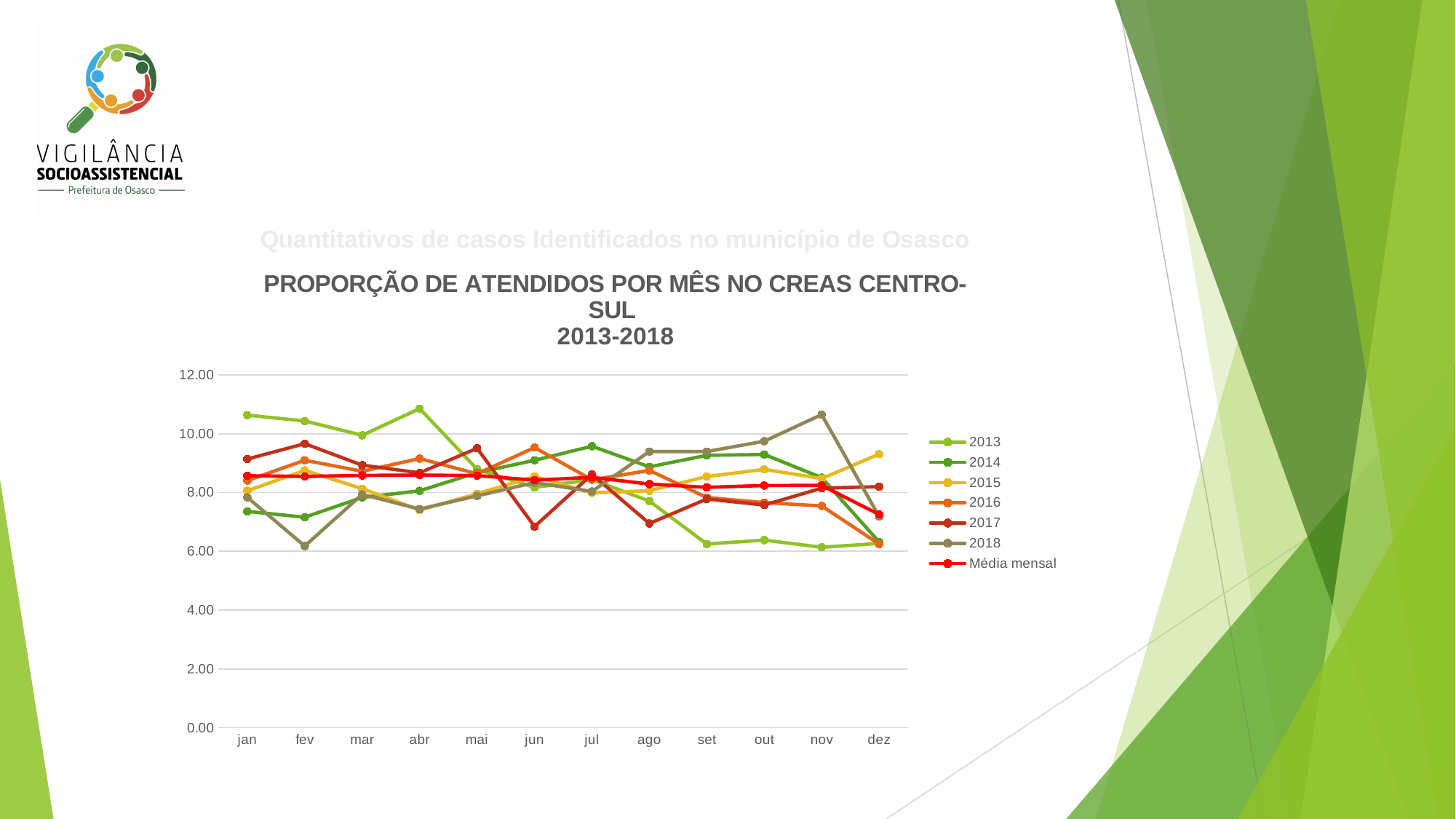
What kind of chart is shown on the slide? line chart Does the 2013 series rise or fall overall from jan to dez? fall Which series has the highest value in jan? 2013 How many months are shown along the x axis? 12 Is the value for 2013 in abr greater or less than 10.00? greater Which series has the lowest value in fev? 2018 How many series does the legend list? 7 Which series has the highest value in nov? 2018 Is the value for 2017 in jun greater or less than 8.00? less Is the value for 2018 in fev greater or less than 8.00? less Which is larger in jan: the value for 2013 or the value for 2014? 2013 Which series is drawn in red in the legend? Média mensal